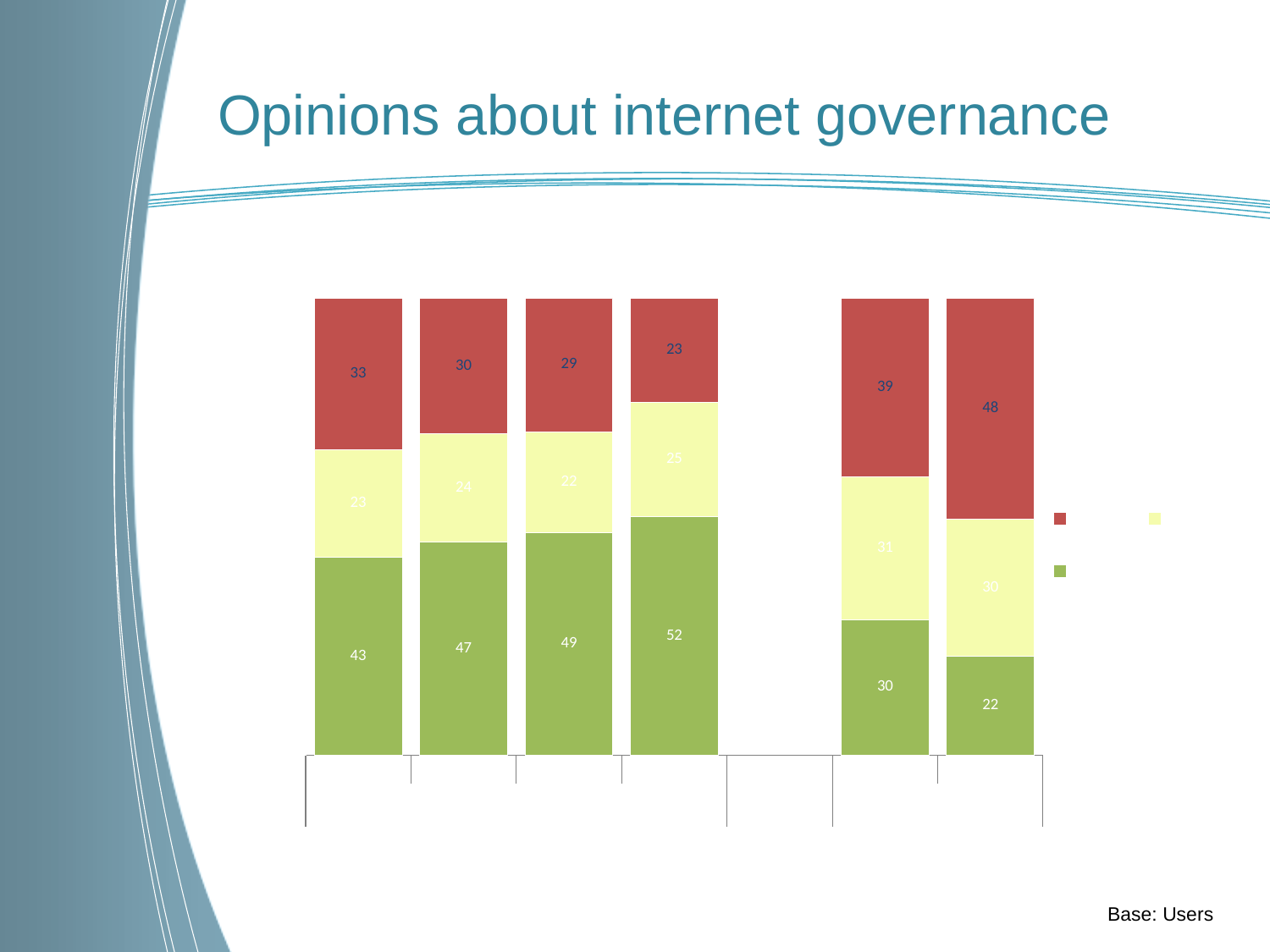
What is the value of the green (bottom) segment of the first bar from the left? 43 What kind of chart is shown on the slide? stacked bar chart What is the title of the chart on the slide? Opinions about internet governance Is the green segment of the second bar from the left larger or smaller than the green segment of the fifth bar from the left? larger Which bar has the smallest green (bottom) segment? the rightmost bar (22) How many stacked bars are plotted in the chart? 6 What is the value of the yellow (middle) segment of the fifth bar from the left? 31 What is the value of the red (top) segment of the rightmost bar? 48 Which bar has the largest green (bottom) segment? the fourth bar from the left (52) How many series (colours) does the legend show? 3 What is the difference between the red segment of the rightmost bar (48) and the red segment of the fourth bar from the left (23)? 25 What is the total of the stacked segments in the fourth bar from the left (23, 25, 52)? 100